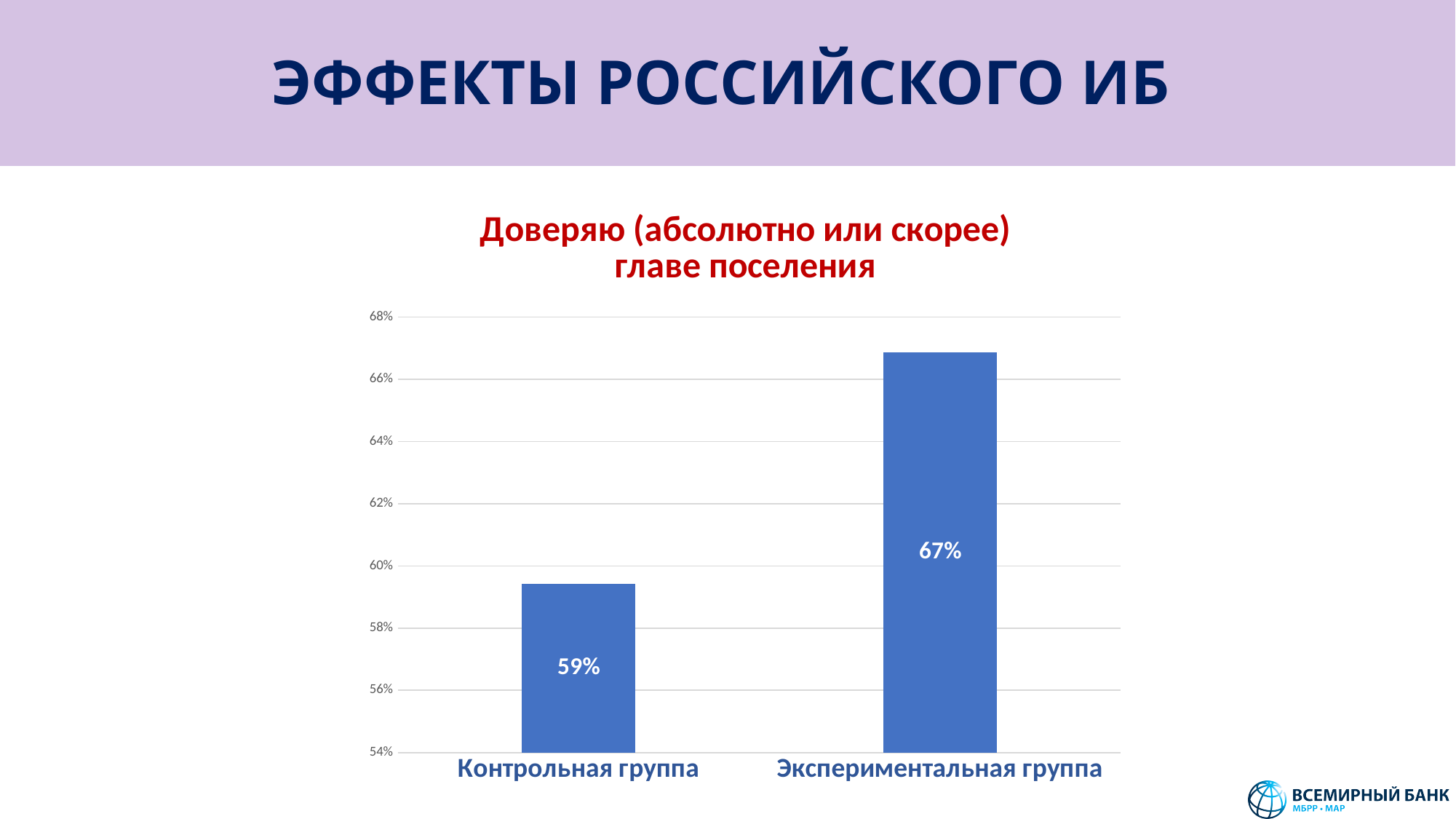
What is the value for Контрольная группа? 59% Is the value for Контрольная группа greater or less than 60%? less What is the value for Экспериментальная группа? 67% Is the value for Контрольная группа larger or smaller than the value for Экспериментальная группа? smaller How many categories are shown in the chart? 2 Is the value for Экспериментальная группа greater or less than 66%? greater What is the highest value shown on the vertical axis? 68% Which group has the higher value? Экспериментальная группа What kind of chart is shown on the slide? bar chart What is the difference between the values for Экспериментальная группа and Контрольная группа? 8% What is the title of the chart? Доверяю (абсолютно или скорее) главе поселения Which group has the lower value? Контрольная группа